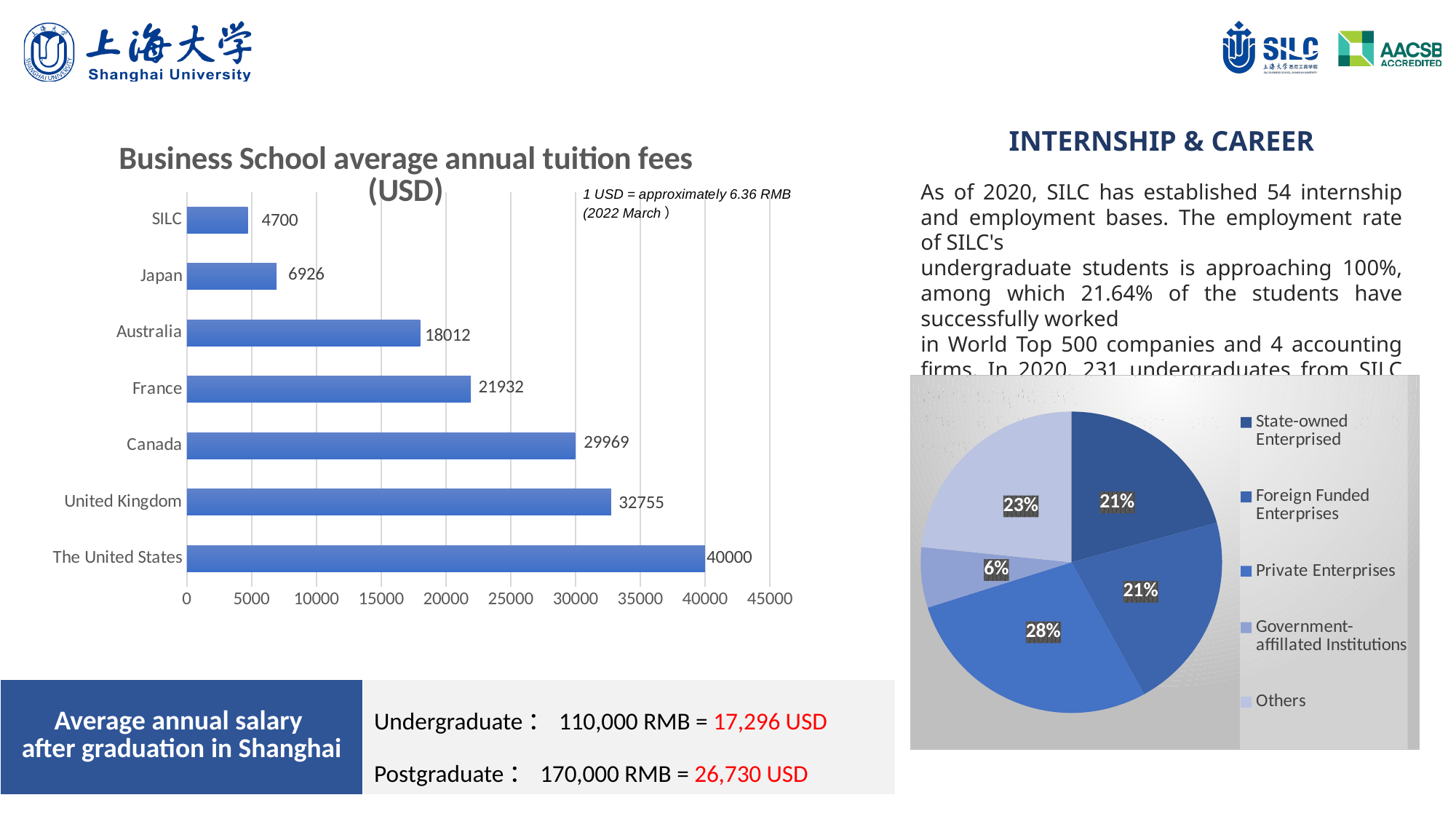
In the bar chart titled 'Business School average annual tuition fees (USD)', which is larger, the value for France or the value for Japan? France In the bar chart titled 'Business School average annual tuition fees (USD)', which category has the lowest value? SILC What kind of chart is the 'Business School average annual tuition fees (USD)' chart? Bar chart In the pie chart on the right of the slide, what share is shown for Government-affiliated Institutions? 6% In the bar chart titled 'Business School average annual tuition fees (USD)', which category has the highest value? The United States In the bar chart titled 'Business School average annual tuition fees (USD)', how many categories are shown? 7 In the pie chart on the right of the slide, which category has the largest slice? Private Enterprises In the bar chart titled 'Business School average annual tuition fees (USD)', what is the value for Australia? 18012 In the bar chart titled 'Business School average annual tuition fees (USD)', what is the difference between the values for the United Kingdom and Canada? 2786 How many entries does the legend of the pie chart on the right of the slide list? 5 In the pie chart on the right of the slide, what share is shown for Private Enterprises? 28% In the bar chart titled 'Business School average annual tuition fees (USD)', what is the value for SILC? 4700